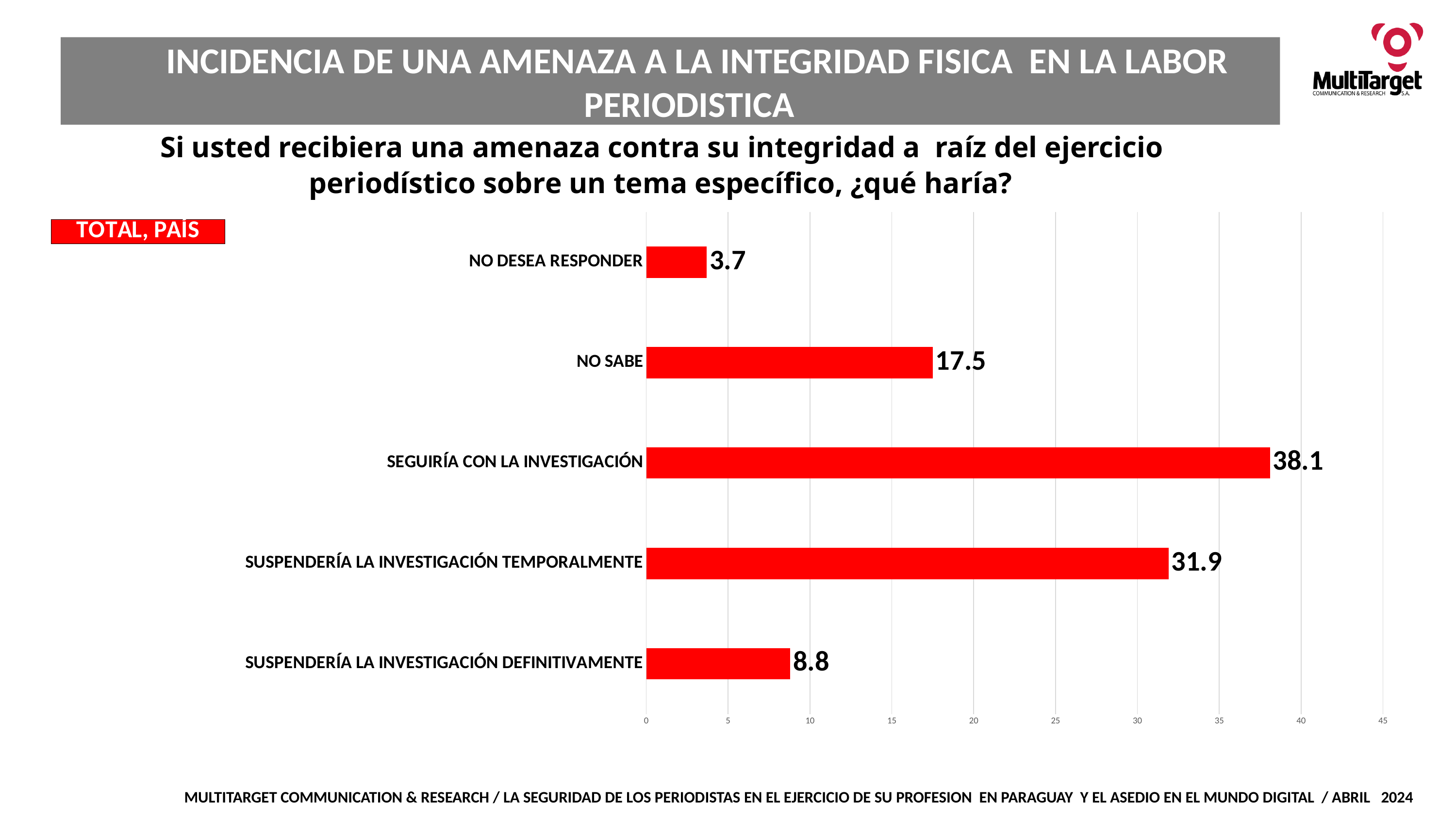
What is the value for NO SABE? 17.5 What is the value for SEGUIRÍA CON LA INVESTIGACIÓN? 38.1 Which category has the lowest value? NO DESEA RESPONDER Is the value for SUSPENDERÍA LA INVESTIGACIÓN TEMPORALMENTE greater or less than 30? greater What is the difference between the values for NO SABE and SUSPENDERÍA LA INVESTIGACIÓN DEFINITIVAMENTE? 8.7 What is the value for SUSPENDERÍA LA INVESTIGACIÓN DEFINITIVAMENTE? 8.8 How many categories are shown in the chart? 5 What colour are the bars in the chart? red Which is larger, the value for NO SABE or the value for SUSPENDERÍA LA INVESTIGACIÓN DEFINITIVAMENTE? NO SABE Which category has the highest value? SEGUIRÍA CON LA INVESTIGACIÓN What is the difference between the values for SEGUIRÍA CON LA INVESTIGACIÓN and SUSPENDERÍA LA INVESTIGACIÓN TEMPORALMENTE? 6.2 What kind of chart is shown on the slide? bar chart